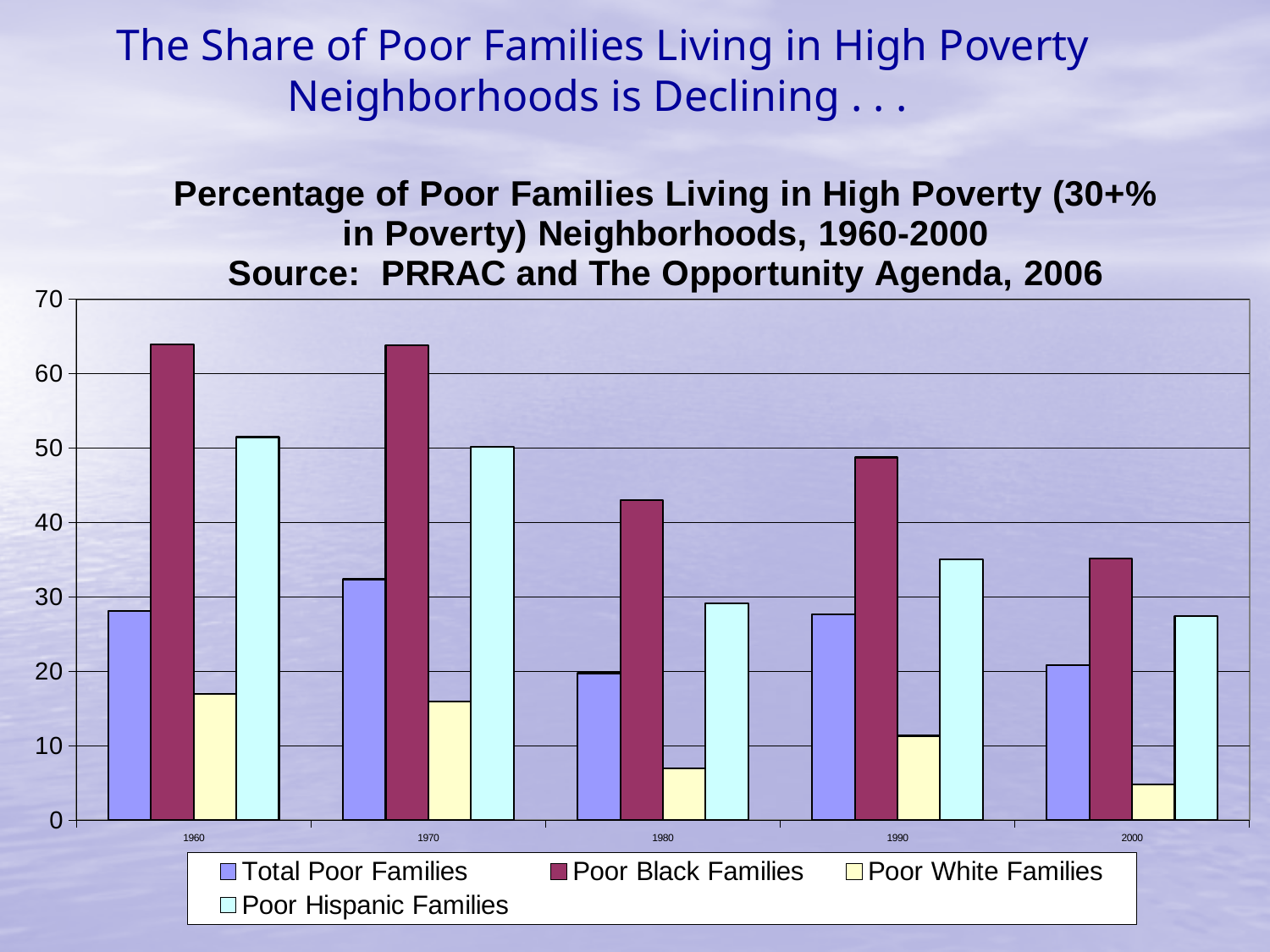
Is the value for Poor Black Families in 1960 greater or less than 60? greater What kind of chart is shown on the slide? Bar chart In 1990, which is larger: Poor Black Families or Poor Hispanic Families? Poor Black Families How many series does the legend list? 4 Is the value for Total Poor Families in 1970 greater or less than 30? greater In which year is the value for Total Poor Families highest? 1970 Is the value for Poor Black Families in 2000 higher or lower than in 1960? lower How many years are shown along the x axis? 5 Is the value for Poor Hispanic Families in 1990 greater or less than 30? greater In which year is the value for Poor Black Families lowest? 2000